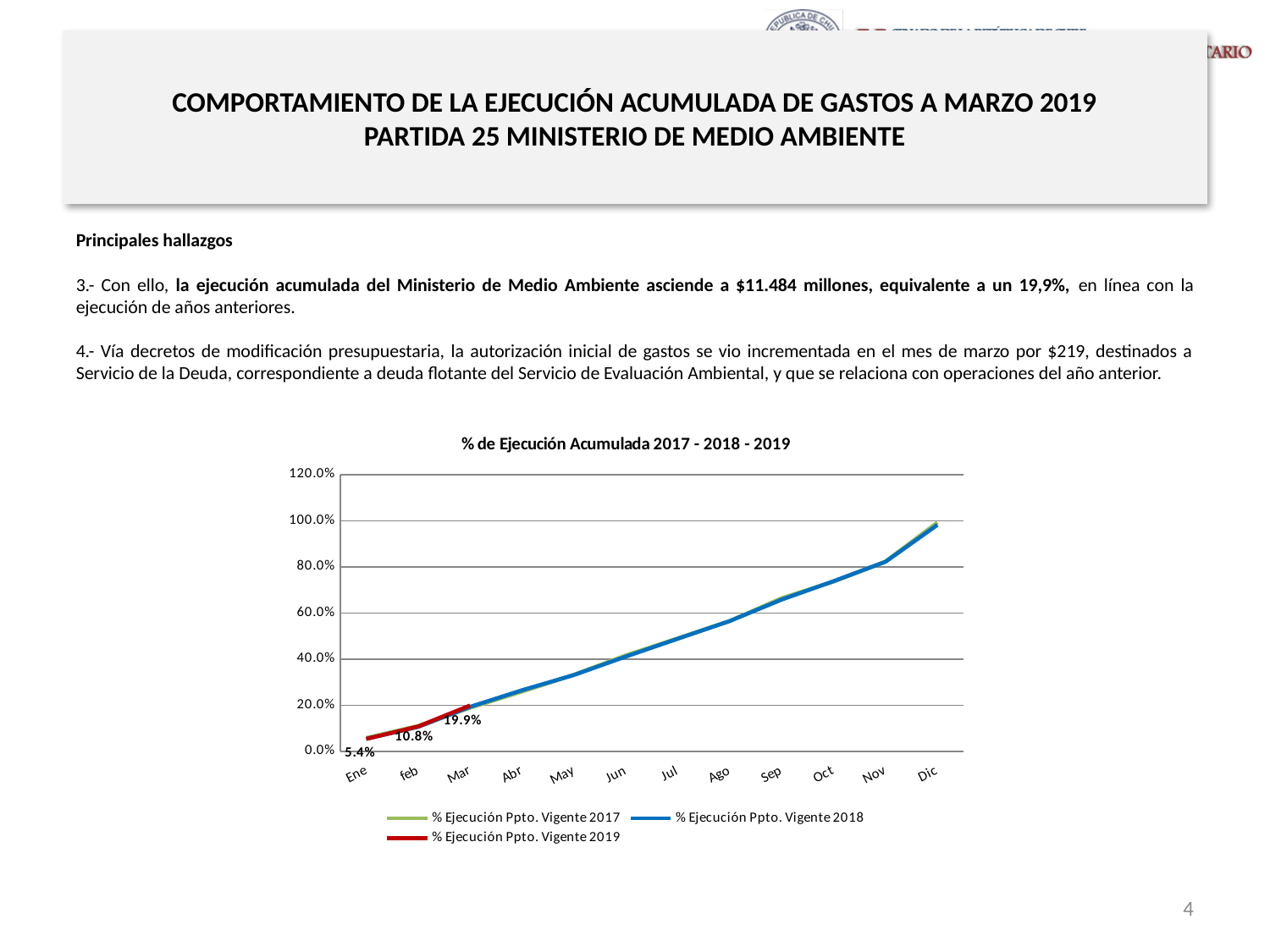
What is the value of % Ejecución Ppto. Vigente 2019 for Mar? 19.9% What is the difference between the 2019 values for Mar and Feb? 9.1 percentage points What is the value of % Ejecución Ppto. Vigente 2019 for Ene? 5.4% Does the % Ejecución Ppto. Vigente 2018 line rise or fall from Ene to Dic? Rise What is the title of the chart? % de Ejecución Acumulada 2017 - 2018 - 2019 How many series does the legend of the chart list? 3 How many months are shown on the x axis of the chart? 12 Is the value of % Ejecución Ppto. Vigente 2018 for Dic greater or less than 80%? greater What kind of chart is shown on the slide? Line chart Is the value of % Ejecución Ppto. Vigente 2018 for Jun greater or less than 60%? less What is the difference between the 2019 values for Feb and Ene? 5.4 percentage points What is the value of % Ejecución Ppto. Vigente 2019 for Feb? 10.8%